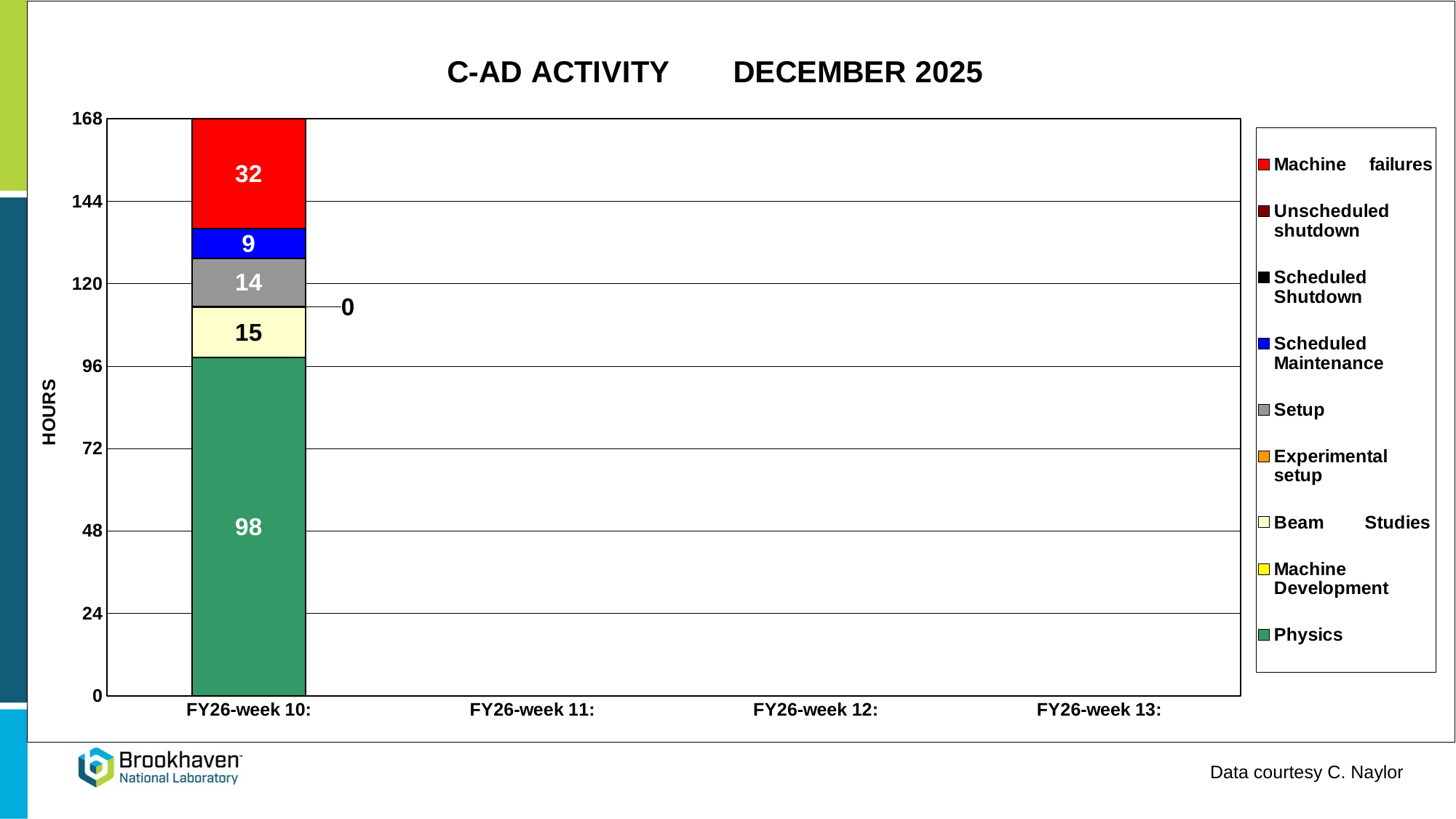
How many hours of Setup are shown for FY26-week 10? 14 What kind of chart is shown on the slide? stacked bar chart How many hours of Beam Studies are shown for FY26-week 10? 15 How many series does the legend list? 9 What is the difference between the Physics hours and the Machine failures hours in FY26-week 10? 66 What is the total height of the stacked bar for FY26-week 10? 168 Which activity has the most hours in FY26-week 10? Physics How many hours of Physics are shown for FY26-week 10? 98 How many hours of Scheduled Maintenance are shown for FY26-week 10? 9 Which is larger for FY26-week 10, Beam Studies or Setup? Beam Studies How many hours of Machine failures are shown for FY26-week 10? 32 How many week categories are labelled on the x axis? 4